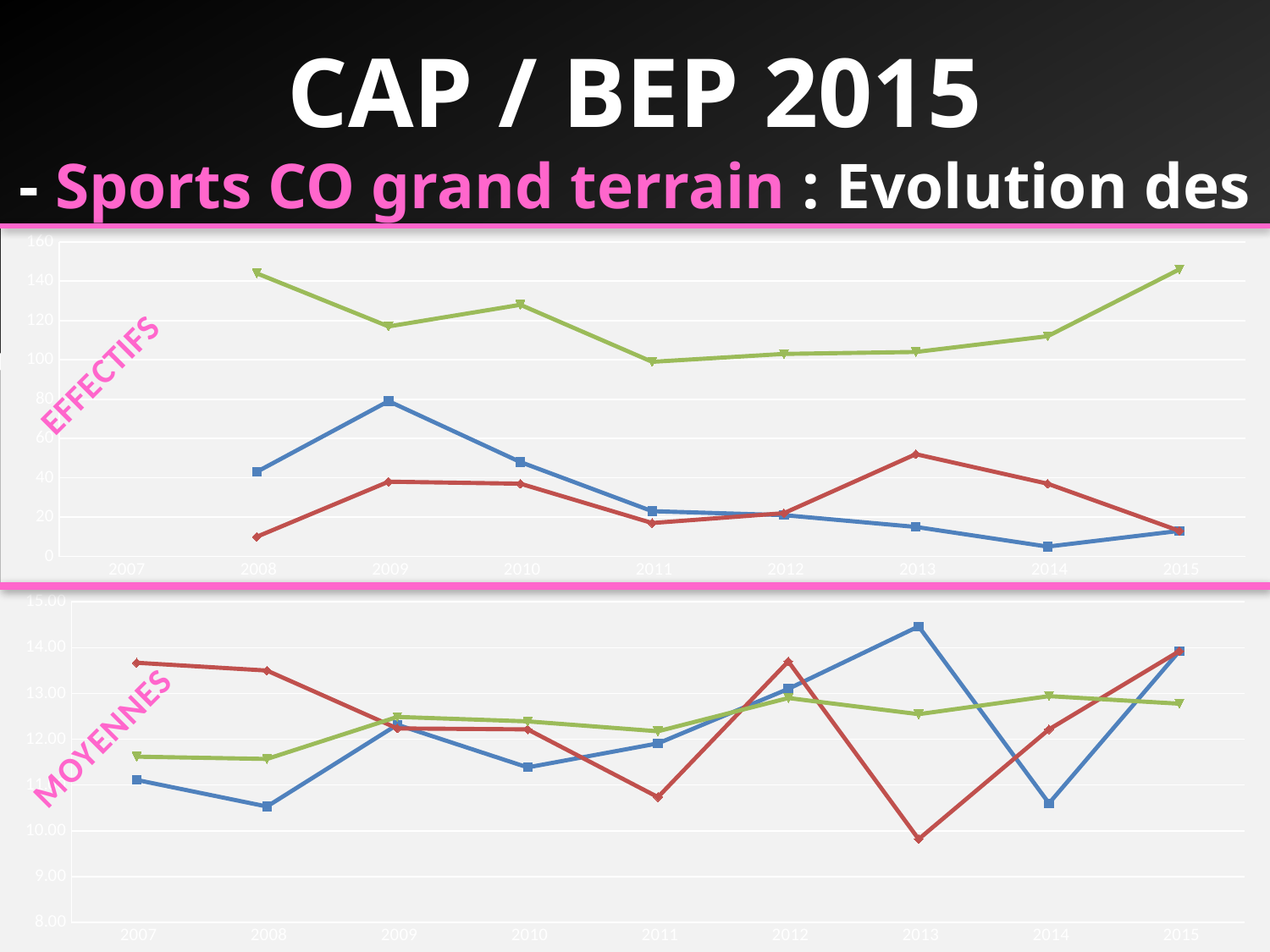
What kind of chart is the top chart labelled EFFECTIFS? line chart On the top chart labelled EFFECTIFS, in which year does the red line reach its highest value? 2013 On the top chart labelled EFFECTIFS, does the green line rise or fall from 2011 to 2015? rise On the bottom chart labelled MOYENNES, in which year does the blue line reach its highest value? 2013 On the top chart labelled EFFECTIFS, in which year does the blue line reach its lowest value? 2014 On the bottom chart labelled MOYENNES, in which year does the red line reach its lowest value? 2013 How many years are shown on the x axis of the bottom chart labelled MOYENNES? 9 How many lines are plotted on the bottom chart labelled MOYENNES? 3 On the bottom chart labelled MOYENNES, is the value of the red line in 2013 greater or less than 10.00? less On the top chart labelled EFFECTIFS, in which year does the blue line reach its highest value? 2009 On the top chart labelled EFFECTIFS, in 2013, which line has the larger value, the red line or the blue line? the red line On the top chart labelled EFFECTIFS, is the value of the green line in 2009 greater or less than 100? greater